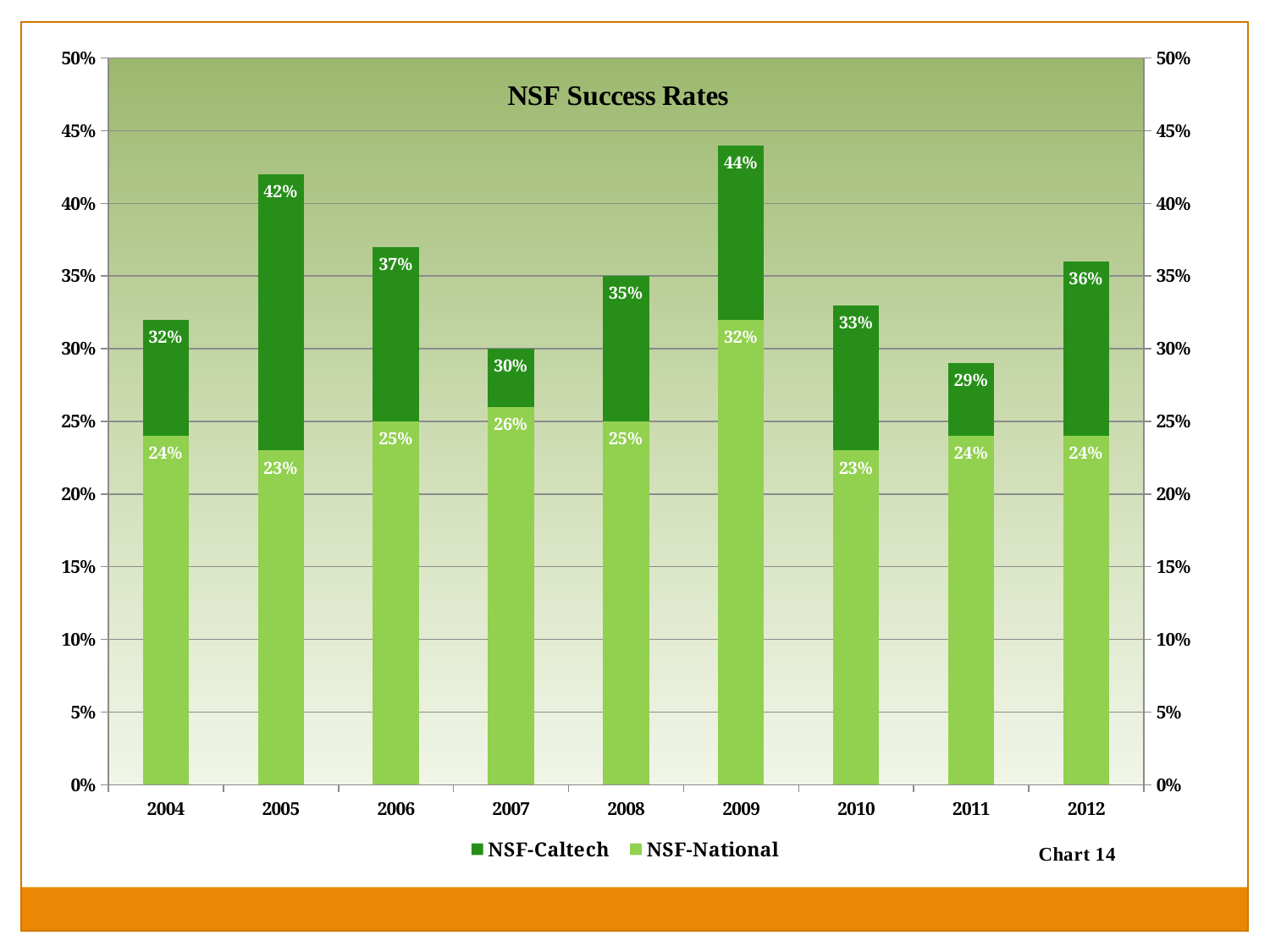
What is the NSF-Caltech success rate for 2009? 44% How many series does the legend list? 2 What is the title of the chart? NSF Success Rates Which is larger, the NSF-Caltech success rate in 2006 or in 2008? 2006 What is the NSF-National success rate for 2007? 26% In which year is the NSF-Caltech success rate lowest? 2011 In which year is the NSF-National success rate highest? 2009 What is the NSF-Caltech success rate for 2011? 29% In which year is the NSF-Caltech success rate highest? 2009 How many years are shown on the x axis? 9 What kind of chart is shown on the slide? Bar chart What is the difference between the NSF-Caltech and NSF-National success rates in 2005? 19%